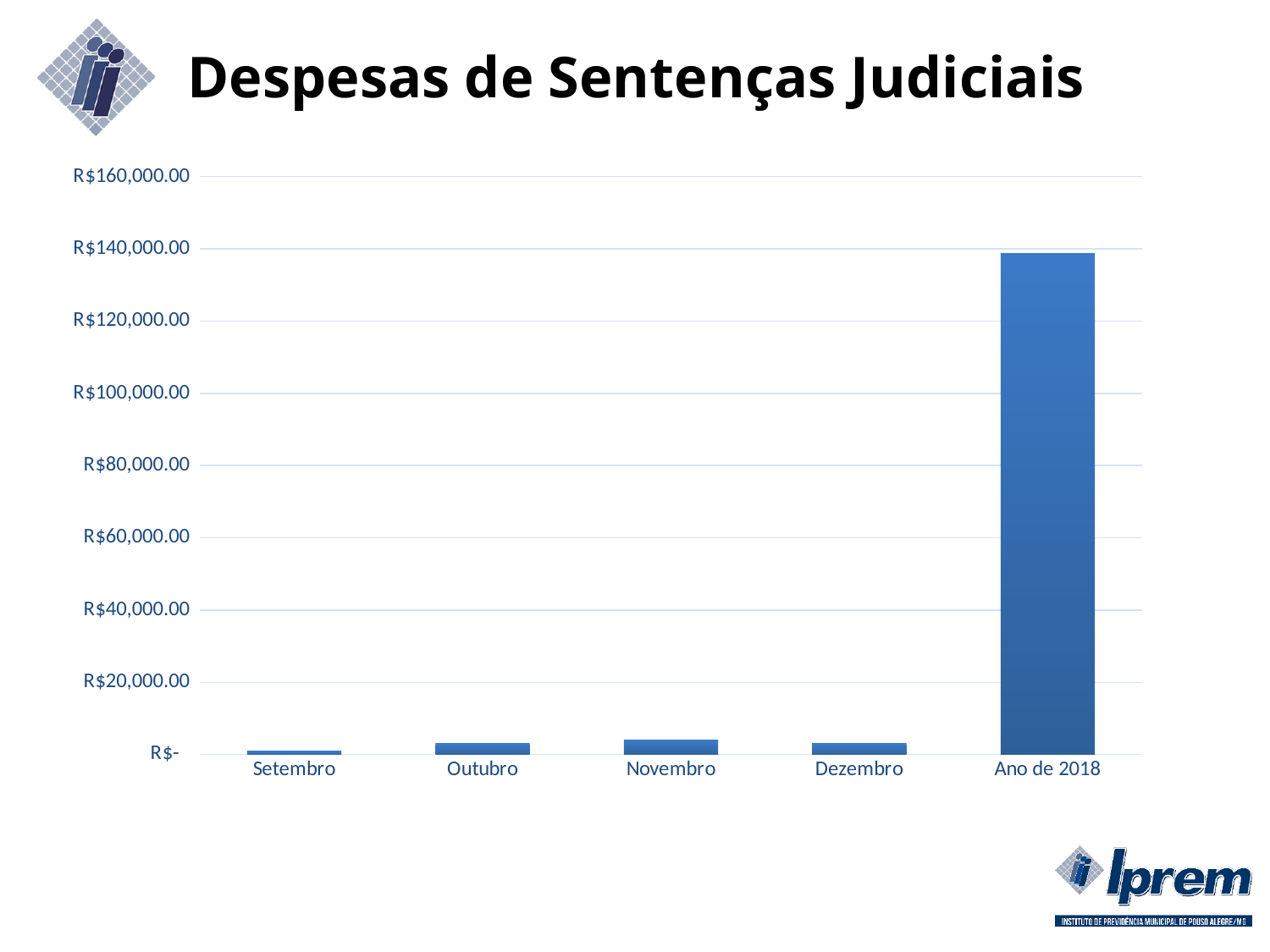
Which category has the lowest value? Setembro What kind of chart is shown on the slide? bar chart Is the value for Novembro greater or less than R$20,000.00? less Is the value for Setembro greater or less than R$20,000.00? less Which is larger, the value for Ano de 2018 or the value for Dezembro? Ano de 2018 Which is larger, the value for Novembro or the value for Setembro? Novembro What is the label of the last category on the x axis? Ano de 2018 Is the value for Ano de 2018 greater or less than R$120,000.00? greater What is the title of the slide? Despesas de Sentenças Judiciais How many categories are shown on the x axis? 5 Which category has the highest value? Ano de 2018